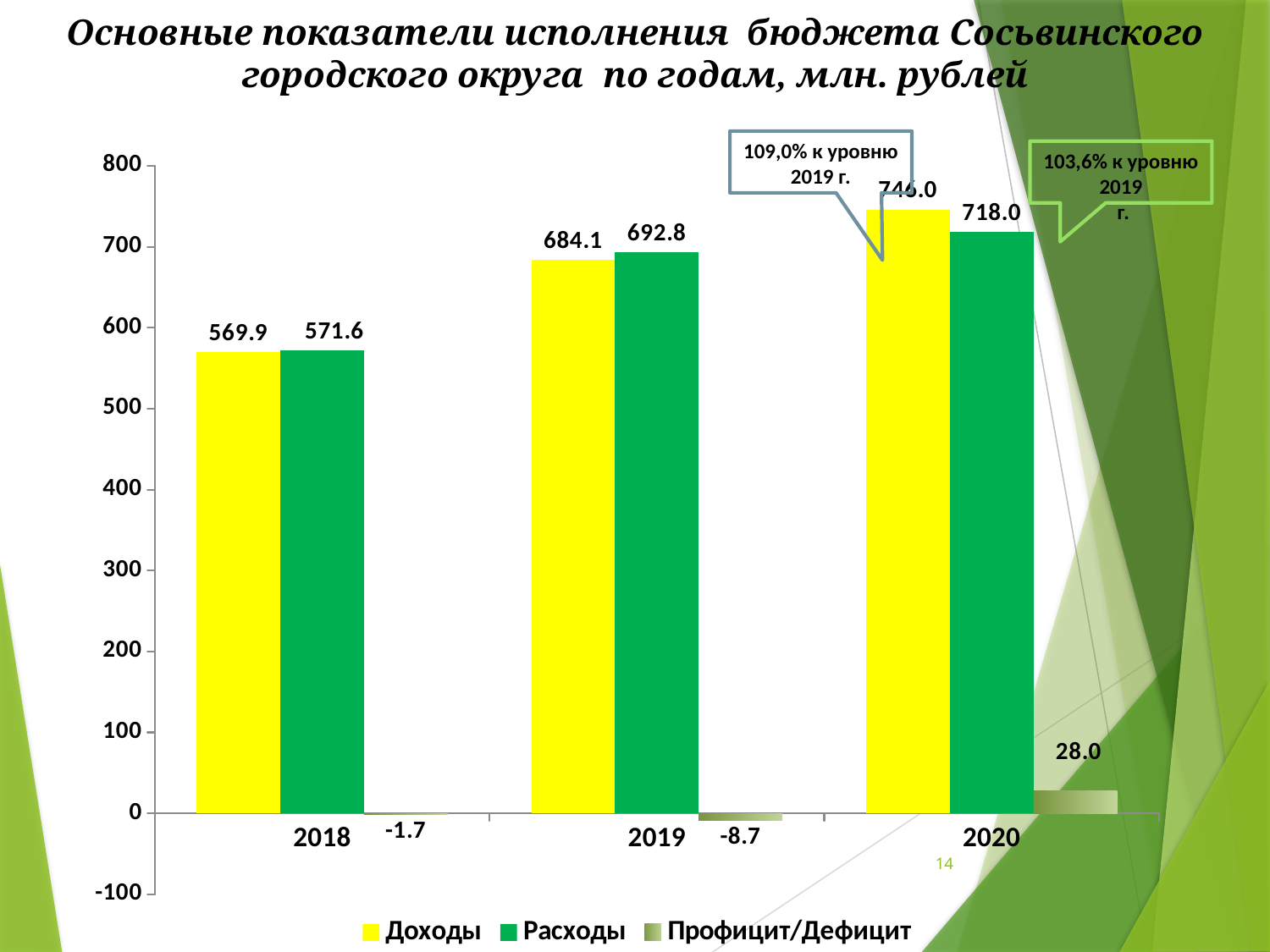
How many years are shown on the x axis? 3 Do the Доходы values rise or fall from 2018 to 2020? rise What is the value of Расходы for 2020? 718.0 What is the value of Расходы for 2019? 692.8 In which year is Расходы the lowest? 2018 How many series does the legend list? 3 What is the value of Профицит/Дефицит for 2019? -8.7 What is the value of Профицит/Дефицит for 2020? 28.0 Is the value of Доходы for 2020 greater or less than 700? greater What is the difference between Расходы and Доходы in 2019? 8.7 What is the value of Доходы for 2018? 569.9 What kind of chart is shown on the slide? bar chart